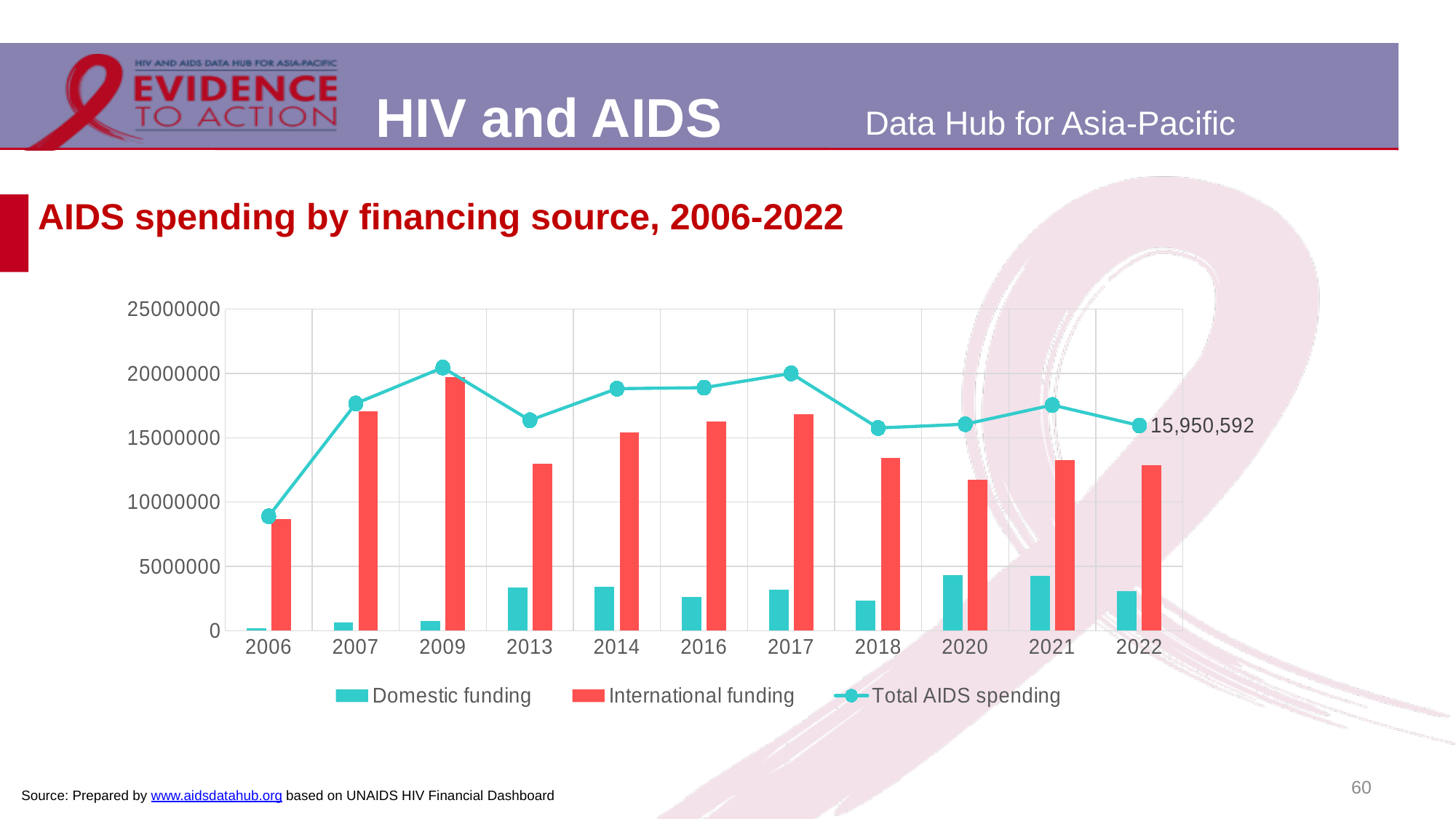
Which year has the highest International funding? 2009 How many series does the legend list? 3 Which is larger, International funding in 2007 or in 2013? 2007 Is the International funding for 2006 greater or less than 10000000? less How many years are shown on the x axis of the chart? 11 Does Total AIDS spending rise or fall from 2017 to 2018? fall Which year has the lowest Domestic funding? 2006 Is the Total AIDS spending for 2007 greater or less than 15000000? greater What is the title of the chart? AIDS spending by financing source, 2006-2022 What kind of chart is shown on the slide? A bar chart combined with a line chart Which year has the lowest Total AIDS spending? 2006 What is the value of Total AIDS spending in 2022? 15,950,592